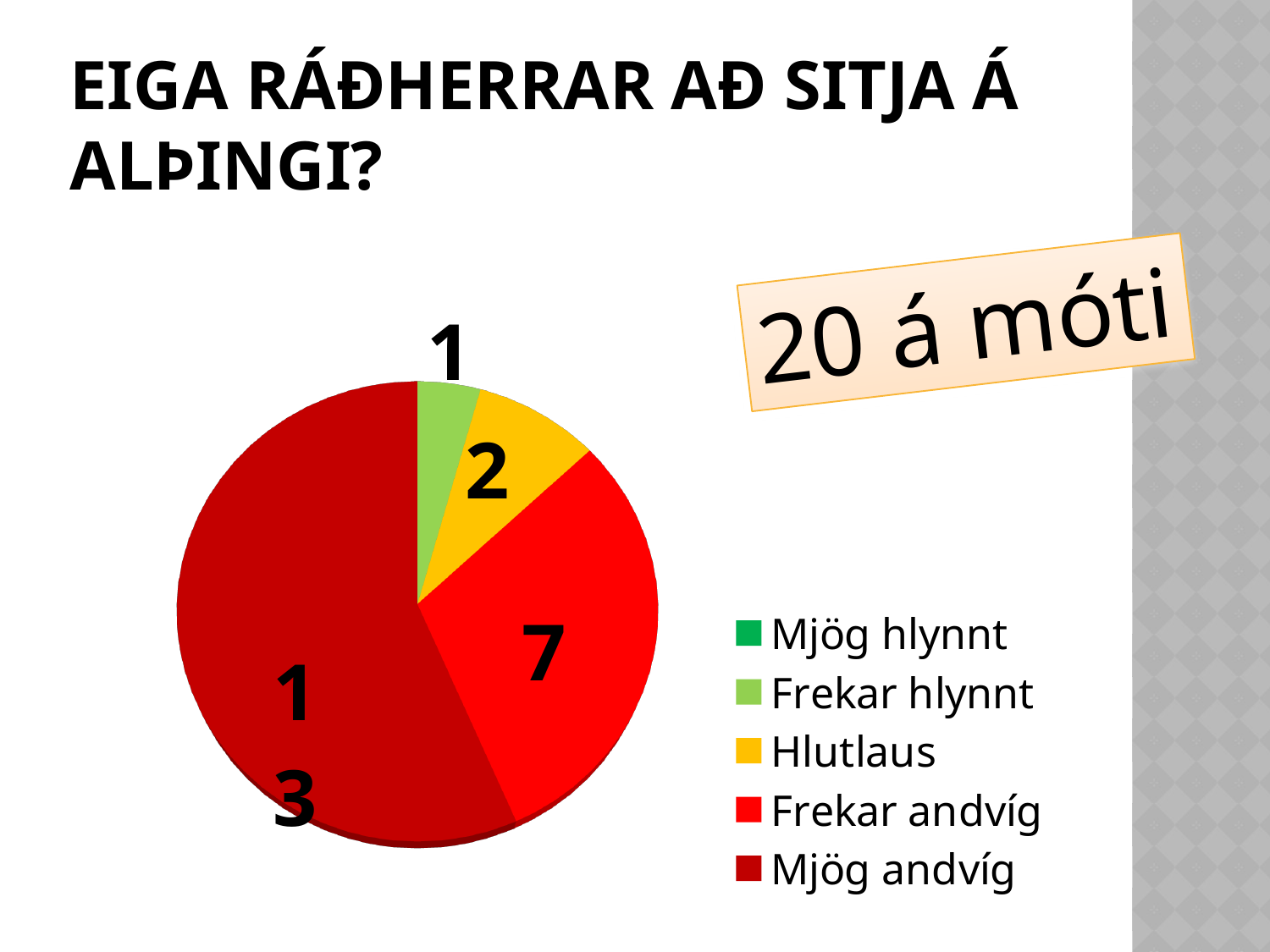
What is the value for Frekar hlynnt in the pie chart? 1 How many entries does the legend of the pie chart list? 5 What colour is the Hlutlaus slice in the pie chart? yellow What type of chart is shown on the slide? pie chart Which category has the largest slice in the pie chart? Mjög andvíg What is the title of the slide containing the pie chart? EIGA RÁÐHERRAR AÐ SITJA Á ALÞINGI? What is the value for Frekar andvíg in the pie chart? 7 Which is larger, the value for Hlutlaus or the value for Frekar hlynnt? Hlutlaus What is the value for Mjög andvíg in the pie chart? 13 What is the combined value of the Frekar andvíg and Mjög andvíg slices? 20 What is the difference between the values for Mjög andvíg and Frekar andvíg? 6 What is the value for Hlutlaus in the pie chart? 2